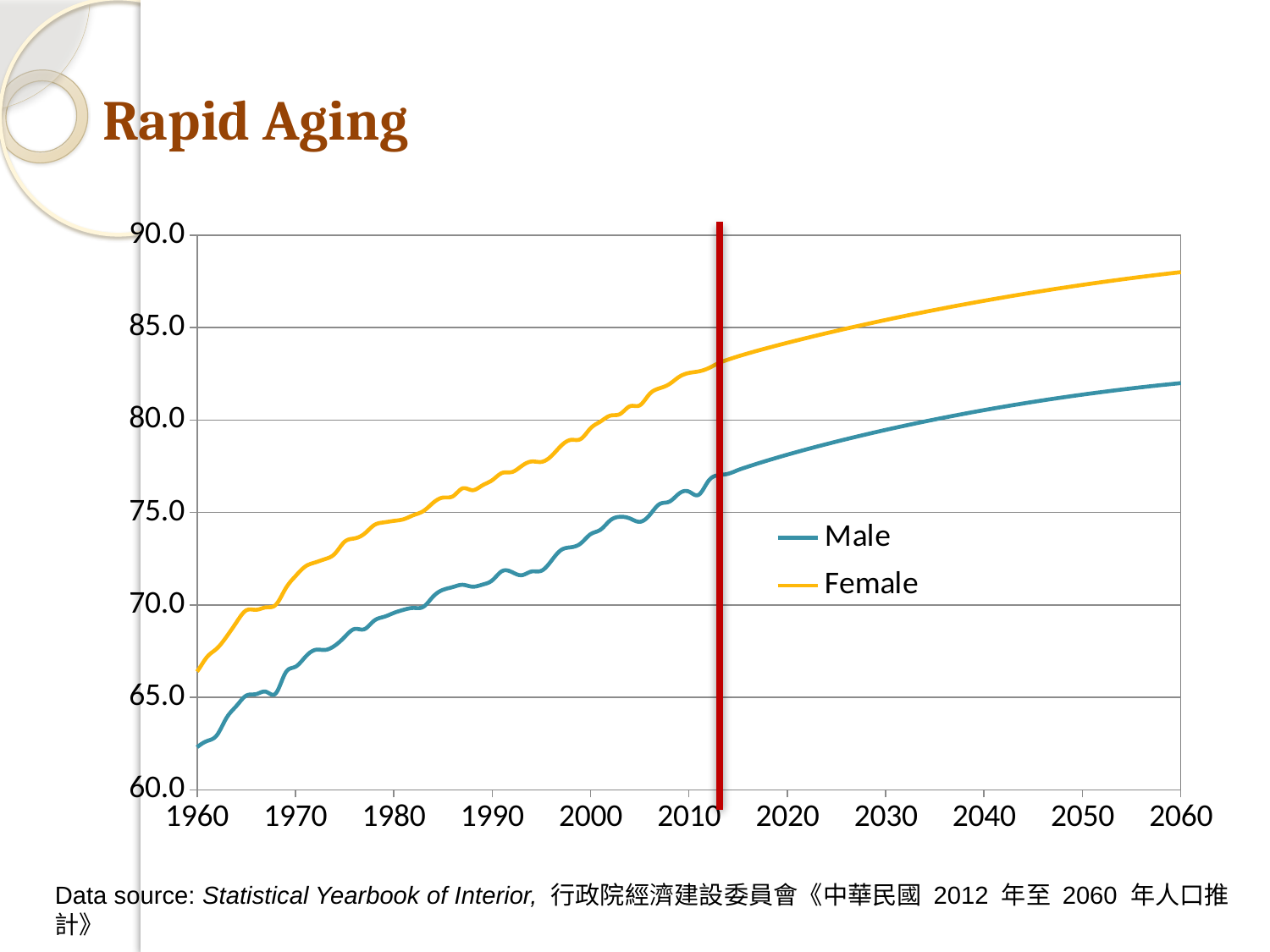
What kind of chart is shown on the slide? line chart Is the value for Female in 2010 greater or less than 80.0? greater Is the value for Male in 1990 greater or less than 70.0? greater In 2060, which series has the higher value, Male or Female? Female Is the value for Female in 2060 greater or less than 85.0? greater What is the title of the slide containing the chart? Rapid Aging How many series does the legend list? 2 Do the values for the Male series rise or fall from 1960 to 2060? rise Do the values for the Female series rise or fall from 1960 to 2060? rise What are the two series named in the legend? Male and Female